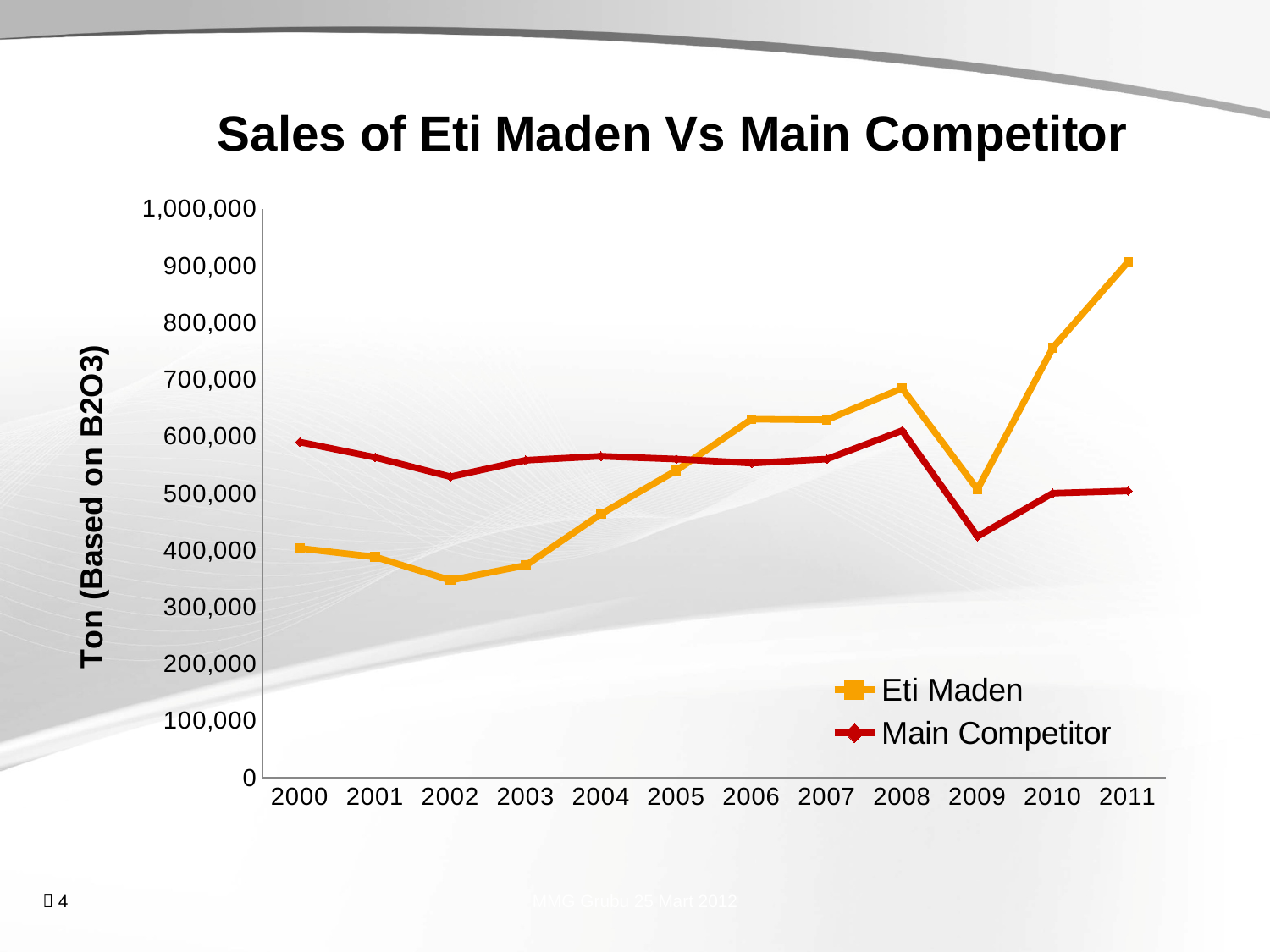
Is the value for Eti Maden in 2011 greater or less than 800,000? greater Is the value for Eti Maden in 2002 greater or less than 400,000? less Is the value for Main Competitor in 2009 greater or less than 500,000? less How many series does the legend list? 2 What kind of chart is shown on the slide? Line chart In which year does the Main Competitor have its lowest sales? 2009 In 2011, which series has higher sales, Eti Maden or Main Competitor? Eti Maden In which year does Eti Maden have its lowest sales? 2002 In 2000, which series has higher sales, Eti Maden or Main Competitor? Main Competitor In which year does Eti Maden reach its highest sales? 2011 What is the title of the y axis? Ton (Based on B2O3) How many years are plotted along the x axis? 12